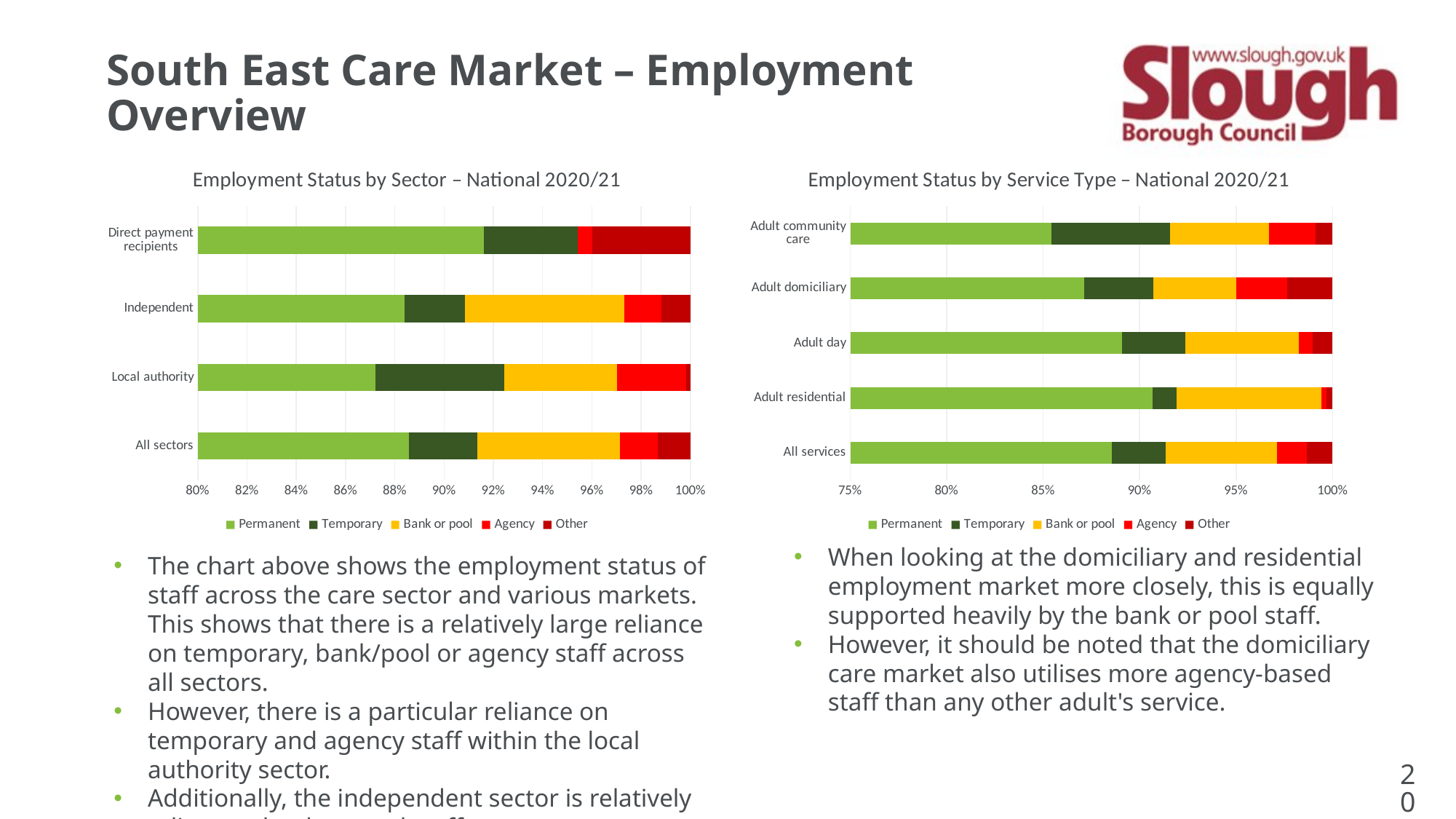
How many categories are shown on the 'Employment Status by Sector – National 2020/21' chart? 4 How many categories are shown on the 'Employment Status by Service Type – National 2020/21' chart? 5 What colour represents the 'Bank or pool' series in the legend of the 'Employment Status by Sector – National 2020/21' chart? Yellow How many series does the legend list on the 'Employment Status by Service Type – National 2020/21' chart? 5 On the 'Employment Status by Sector – National 2020/21' chart, is the Permanent share for Direct payment recipients greater or less than 90%? greater On the 'Employment Status by Sector – National 2020/21' chart, which category has the largest Permanent share? Direct payment recipients On the 'Employment Status by Service Type – National 2020/21' chart, is the Permanent share for Adult residential greater or less than 90%? greater On the 'Employment Status by Service Type – National 2020/21' chart, which has the larger Permanent share, Adult day or Adult domiciliary? Adult day On the 'Employment Status by Service Type – National 2020/21' chart, which service type has the largest Permanent share? Adult residential What kind of chart is the 'Employment Status by Sector – National 2020/21' chart? Stacked bar chart On the 'Employment Status by Sector – National 2020/21' chart, which category has the smallest Permanent share? Local authority On the 'Employment Status by Service Type – National 2020/21' chart, which service type has the smallest Permanent share? Adult community care